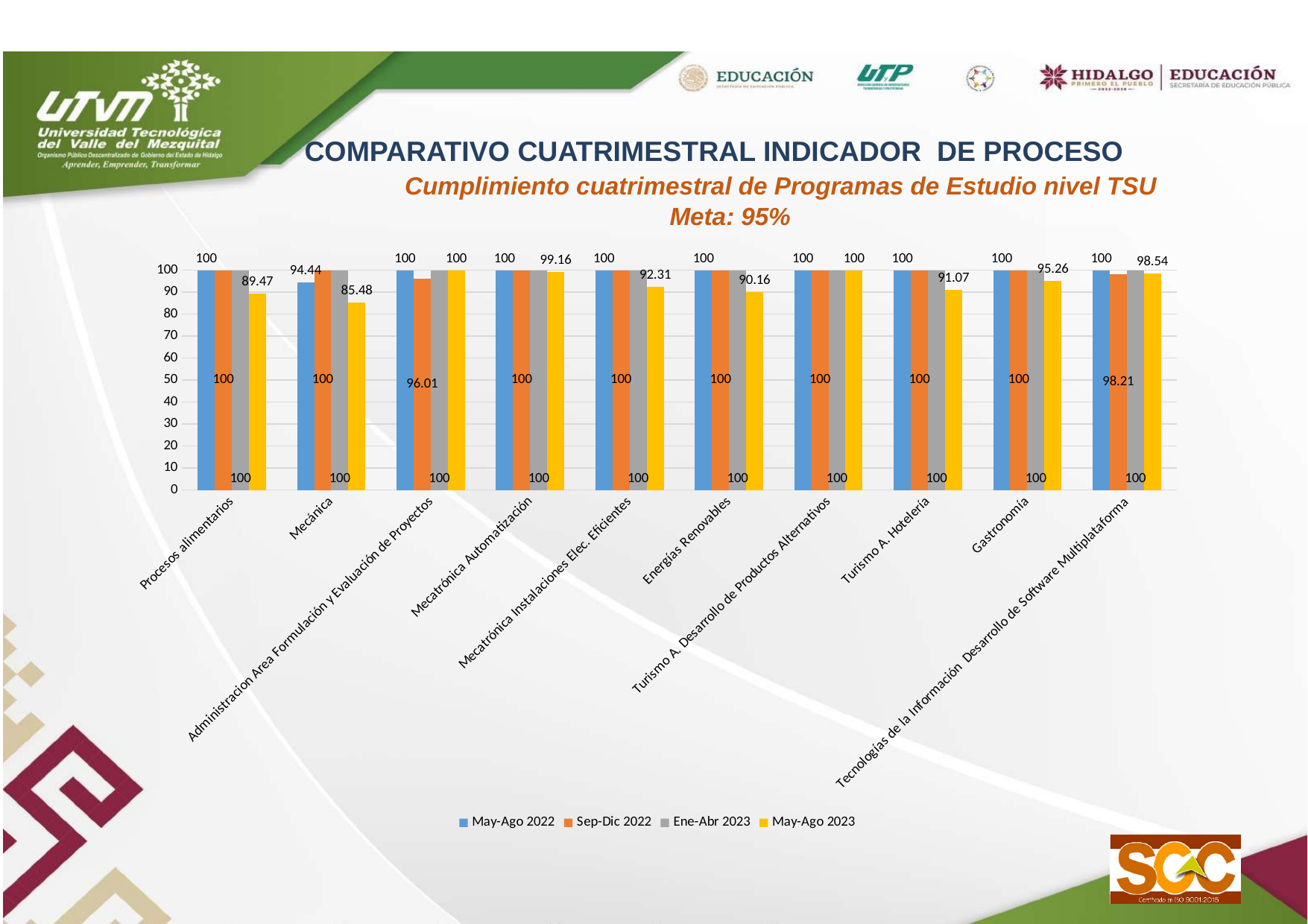
What is the May-Ago 2023 value for Energías Renovables? 90.16 What is the difference between the May-Ago 2022 and May-Ago 2023 values for Procesos alimentarios? 10.53 Which program has the lowest May-Ago 2023 value? Mecánica What kind of chart is shown on the slide? bar chart What is the May-Ago 2022 value for Mecánica? 94.44 Is the May-Ago 2023 value for Mecánica greater or less than 90? less Which has the larger May-Ago 2023 value, Gastronomía or Turismo A. Hotelería? Gastronomía How many series does the legend list? 4 What is the Sep-Dic 2022 value for Administración Area Formulación y Evaluación de Proyectos? 96.01 What target (Meta) is stated above the chart? 95% How many programs (categories) are shown on the x axis? 10 What is the May-Ago 2023 value for Mecánica? 85.48